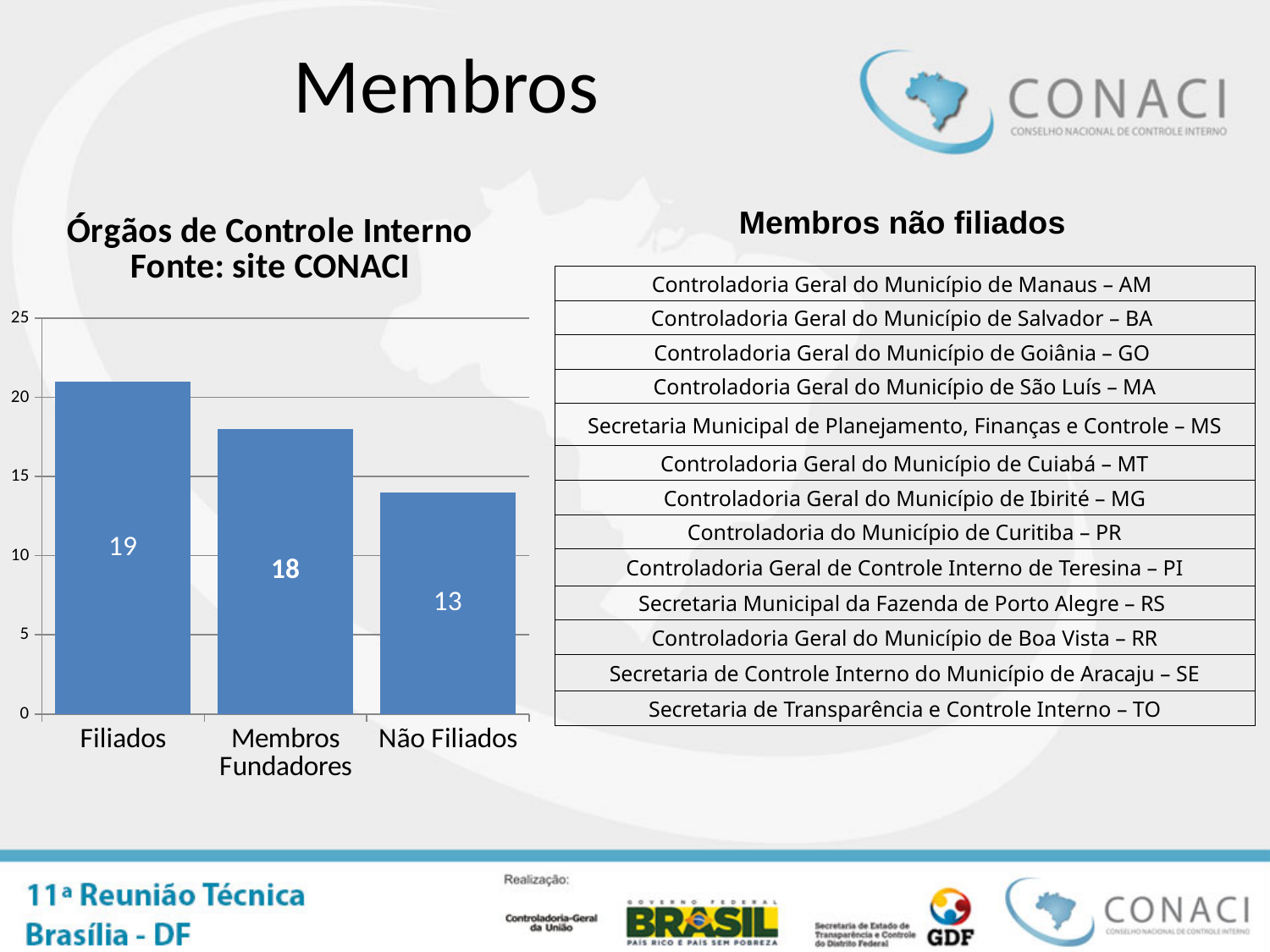
What is the value for Membros Fundadores? 18 Which category has the lowest value? Não Filiados Which is larger, the value for Filiados or the value for Não Filiados? Filiados What kind of chart is shown on the slide? Bar chart What is the title of the chart? Órgãos de Controle Interno Fonte: site CONACI How many categories are shown in the chart? 3 Is the value for Não Filiados greater or less than 10? greater What is the value for Não Filiados? 13 What is the difference between the values for Membros Fundadores and Não Filiados? 5 What is the difference between the values for Filiados and Não Filiados? 6 Which category has the highest value? Filiados What is the value for Filiados? 19